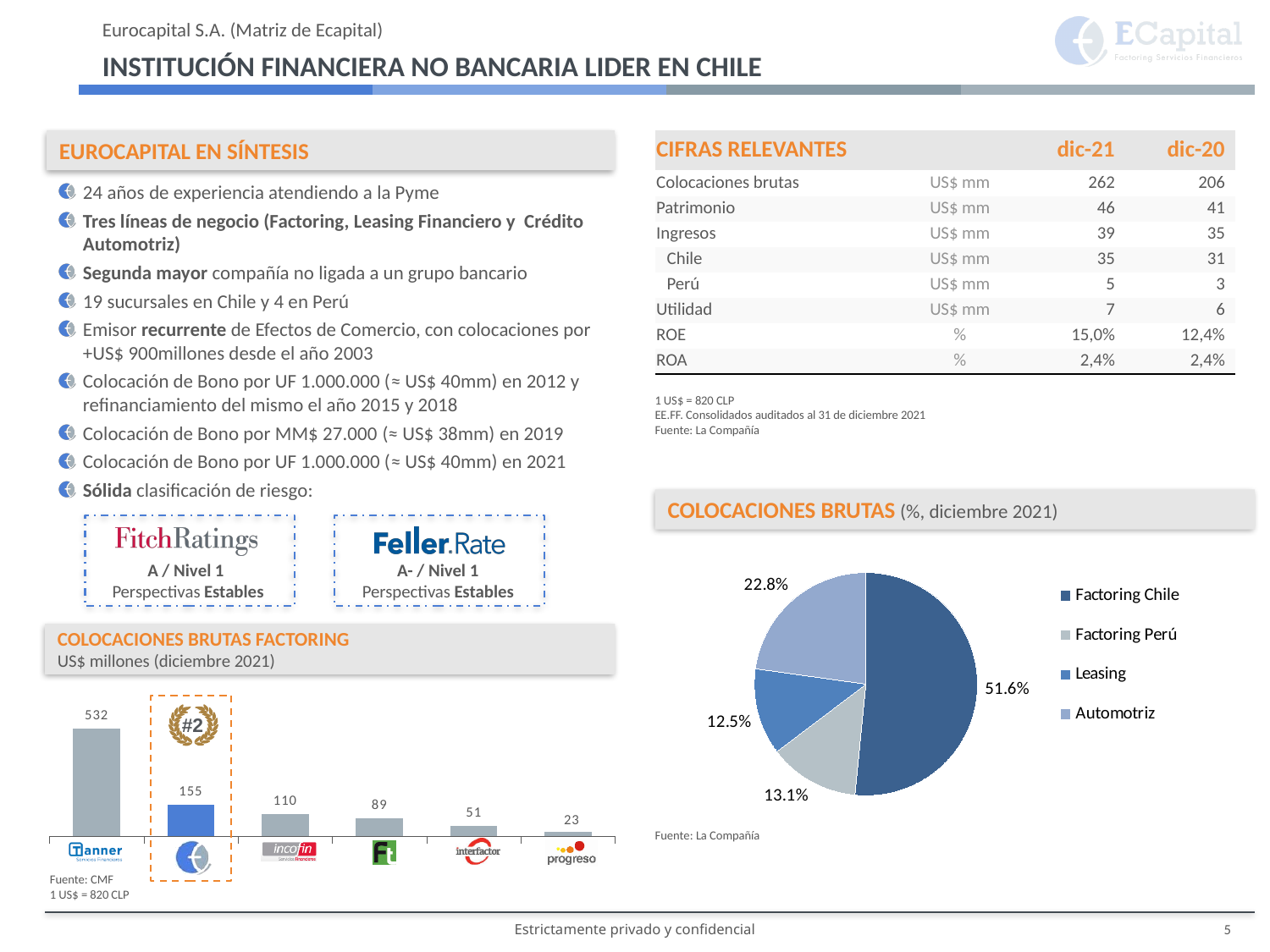
In the COLOCACIONES BRUTAS pie chart, what share does Factoring Chile have? 51.6% In the COLOCACIONES BRUTAS FACTORING bar chart, what is the difference between the Tanner bar and the second-highest bar (155)? 377 In the COLOCACIONES BRUTAS pie chart, what is the difference between the Factoring Perú and Leasing shares? 0.6% In the COLOCACIONES BRUTAS FACTORING bar chart, what is the value for Tanner? 532 In the COLOCACIONES BRUTAS FACTORING bar chart, how many bars are shown? 6 In the COLOCACIONES BRUTAS FACTORING bar chart, what is the value for Incofin? 110 In the COLOCACIONES BRUTAS pie chart, what share does Automotriz have? 22.8% In the COLOCACIONES BRUTAS FACTORING bar chart, what is the value for Progreso? 23 What kind of chart is the COLOCACIONES BRUTAS FACTORING chart at the bottom left? bar chart In the COLOCACIONES BRUTAS pie chart, how many categories does the legend list? 4 In the COLOCACIONES BRUTAS pie chart, which category has the smallest share? Leasing In the COLOCACIONES BRUTAS pie chart, what share does Leasing have? 12.5%